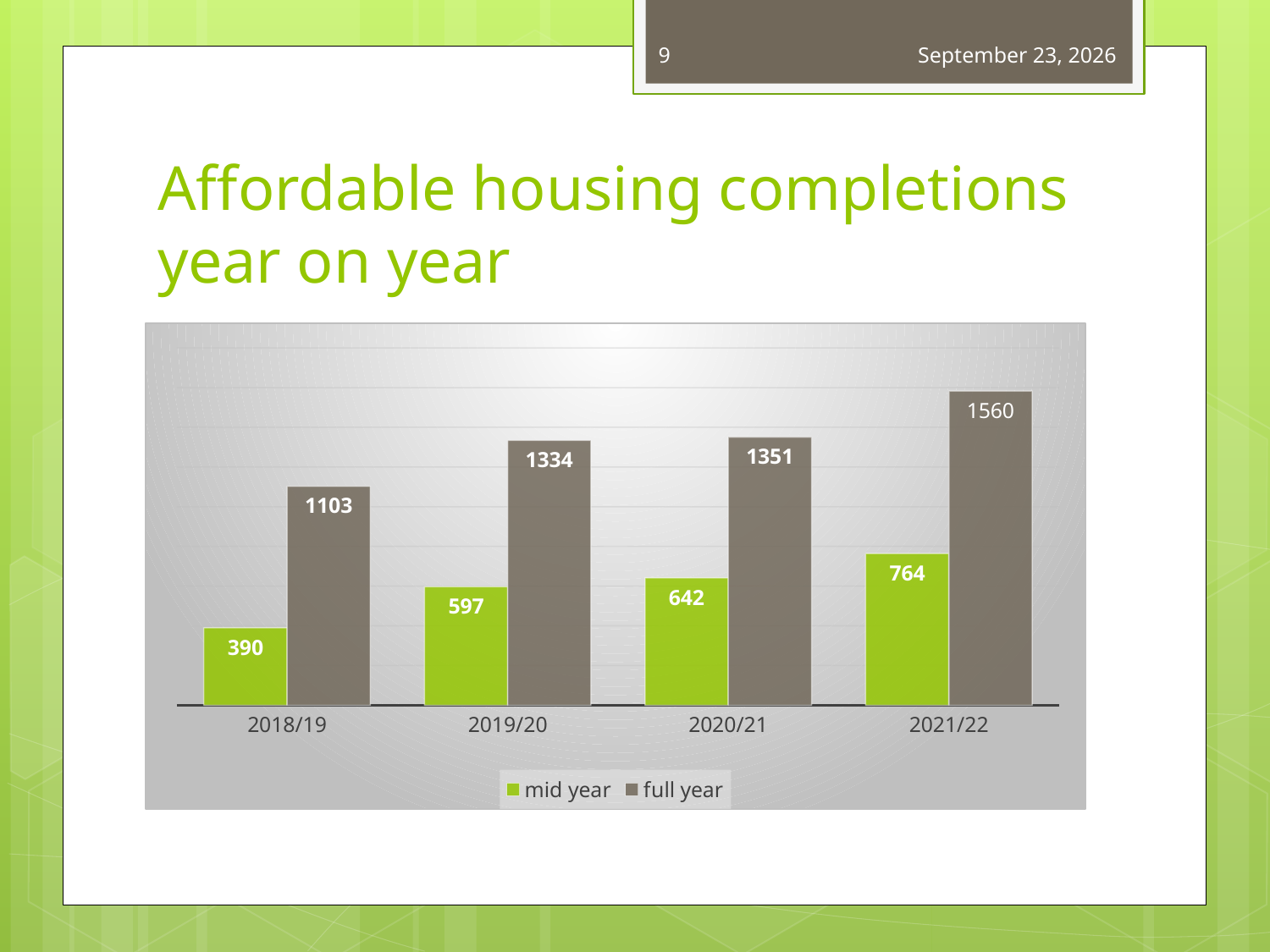
What kind of chart is shown on the slide? bar chart What is the difference between the full year values for 2021/22 and 2018/19? 457 What is the mid year value for 2018/19? 390 Which is larger, the mid year value for 2019/20 or the mid year value for 2021/22? 2021/22 Which year has the lowest mid year value? 2018/19 What is the full year value for 2021/22? 1560 How many series does the legend list? 2 Do the full year values rise or fall from 2018/19 to 2021/22? rise How many years are shown on the x axis? 4 Which year has the highest full year value? 2021/22 What is the full year value for 2019/20? 1334 What is the difference between the full year and mid year values for 2020/21? 709